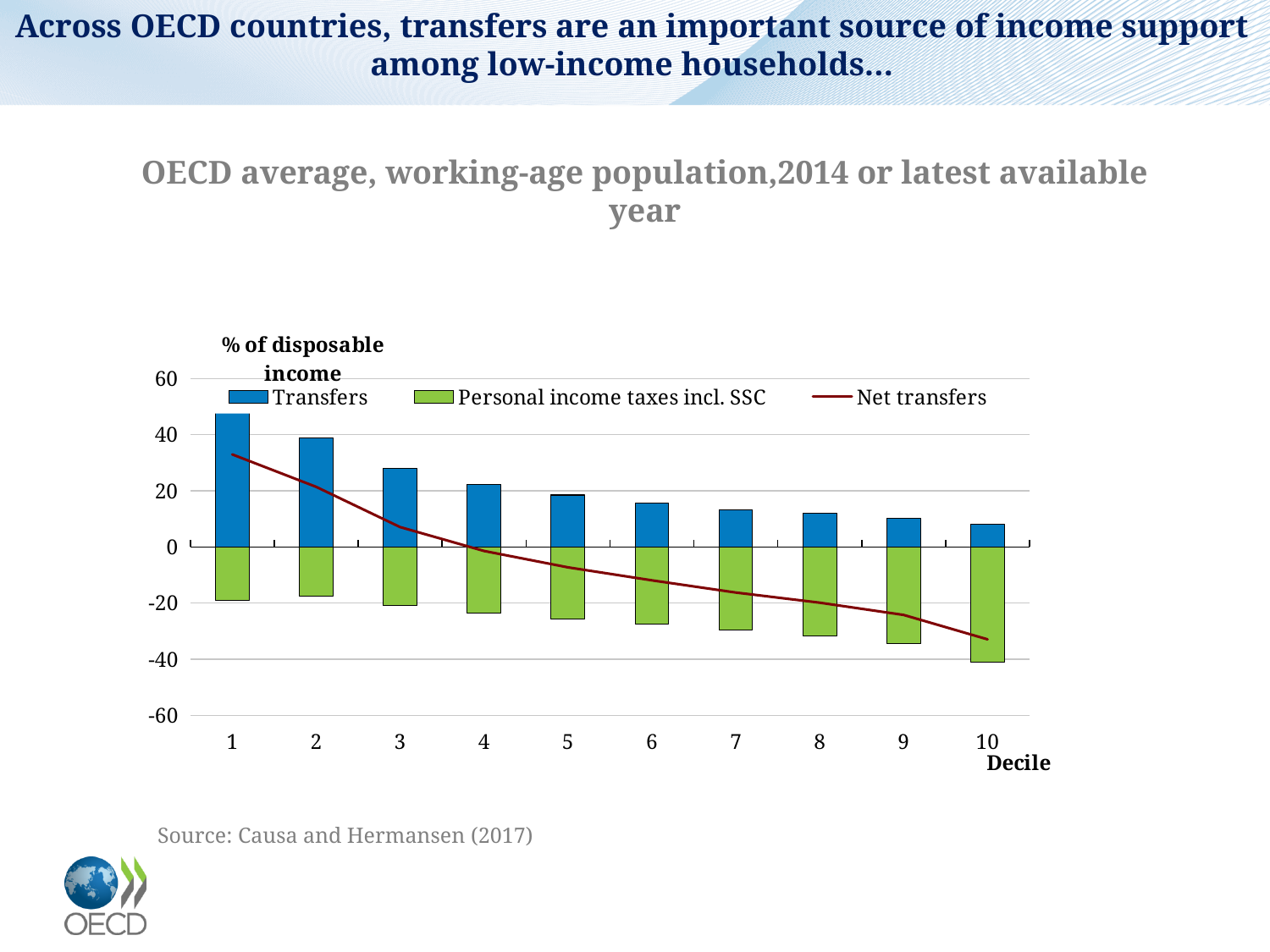
Do the Transfers bars rise or fall as the decile increases from 1 to 10? fall Which decile has the highest Transfers bar? 1 What kind of chart is shown on the slide? bar chart with a line Which is larger, the Transfers value for decile 1 or for decile 5? decile 1 Which decile has the largest (most negative) Personal income taxes incl. SSC bar? 10 Is the Personal income taxes incl. SSC value for decile 9 greater or less than -20? less Which decile has the lowest Transfers bar? 10 How many deciles are shown on the x axis of the chart? 10 What is the label on the x axis of the chart? Decile Is the Transfers value for decile 1 greater or less than 40? greater How many series does the chart's legend list? 3 Does the Net transfers line rise or fall from decile 1 to decile 10? fall